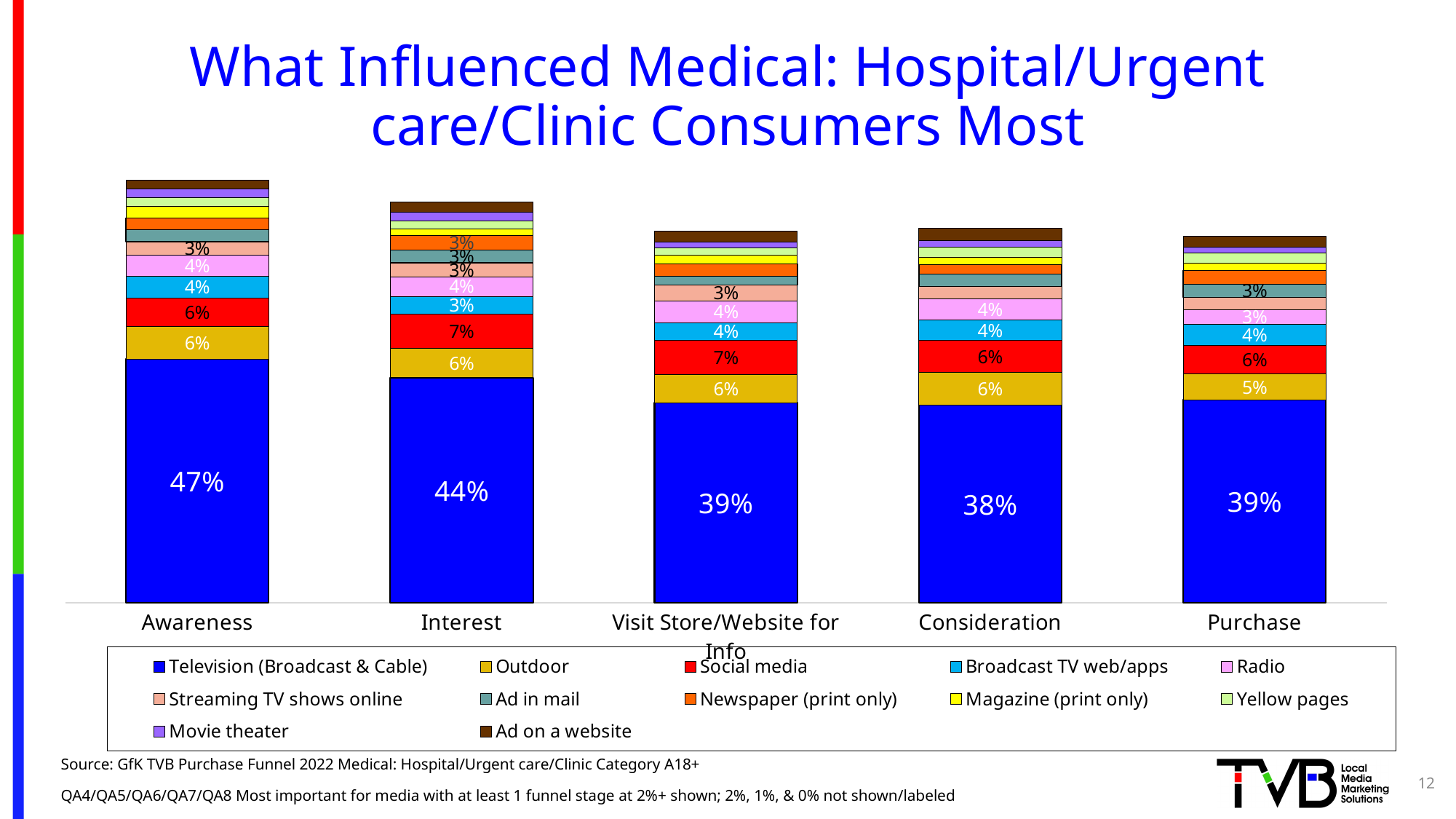
What is the Outdoor value for the Purchase stage? 5% How many series does the legend list? 12 What is the difference between the Television (Broadcast & Cable) values for Awareness and Interest? 3 percentage points Does the Television (Broadcast & Cable) value rise or fall from Awareness to Consideration? Fall How many funnel stages are shown on the x axis? 5 Which funnel stage has the highest Television (Broadcast & Cable) value? Awareness What is the Television (Broadcast & Cable) value for the Consideration stage? 38% What is the Social media value for the Interest stage? 7% Which funnel stage has the lowest Television (Broadcast & Cable) value? Consideration What kind of chart is shown on the slide? Stacked bar chart What percentage of Awareness is attributed to Television (Broadcast & Cable)? 47% In the Interest stage, which is larger: Social media or Outdoor? Social media